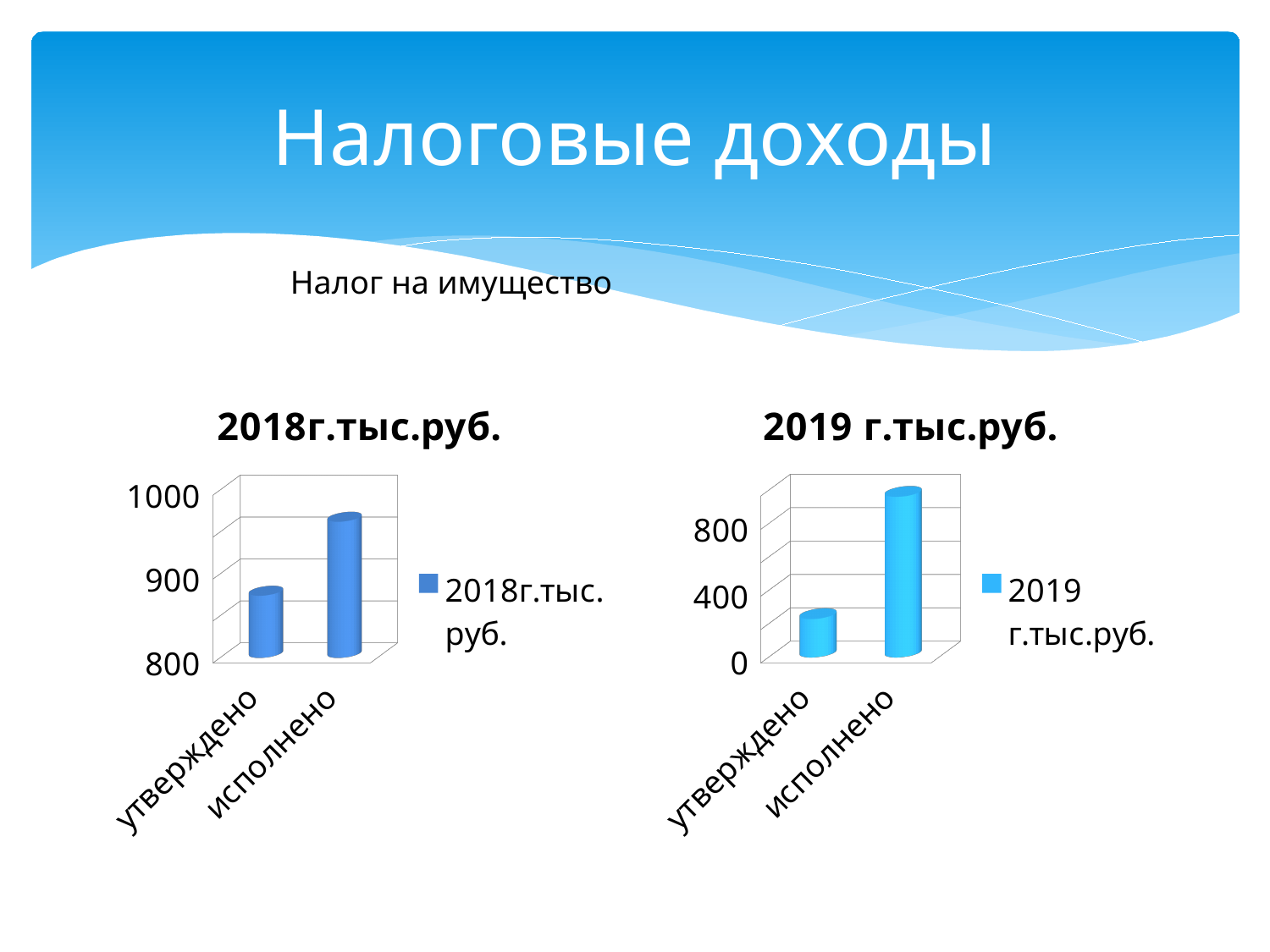
In the "2018г.тыс.руб." chart, which is larger: утверждено or исполнено? исполнено In the "2019 г.тыс.руб." chart, how many series does the legend list? 1 In the "2018г.тыс.руб." chart, is the value for исполнено greater or less than 900? greater In the "2019 г.тыс.руб." chart, which category has the lowest value? утверждено In the "2018г.тыс.руб." chart, is the value for утверждено greater or less than 900? less In the "2018г.тыс.руб." chart, how many categories are shown on the x axis? 2 What kind of chart is the "2019 г.тыс.руб." chart? bar chart What kind of chart is the "2018г.тыс.руб." chart? bar chart In the "2019 г.тыс.руб." chart, is the value for исполнено greater or less than 800? greater What is the legend entry in the "2019 г.тыс.руб." chart? 2019 г.тыс.руб. In the "2018г.тыс.руб." chart, which category has the highest value? исполнено